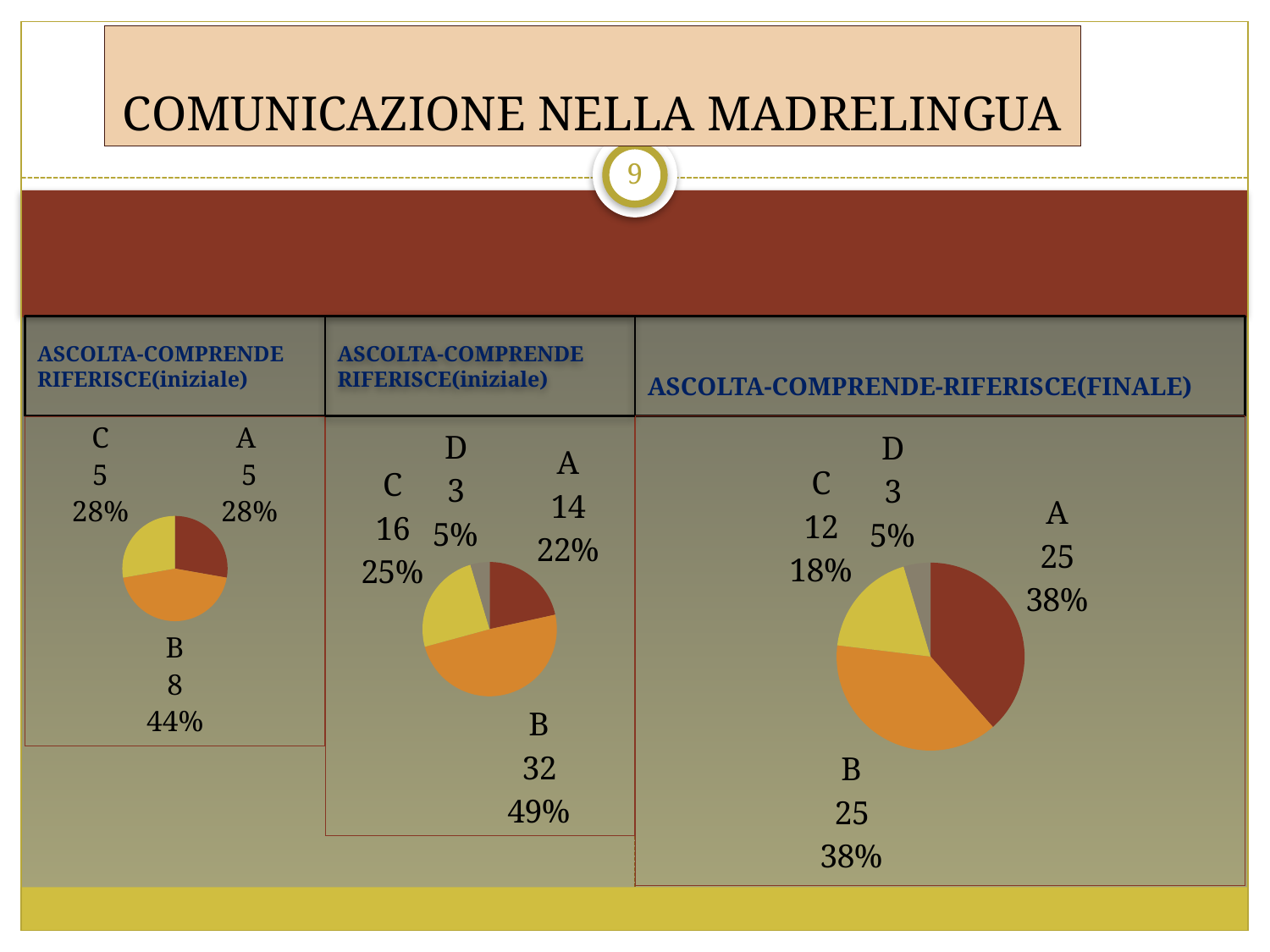
What kind of chart is used in the left-hand chart on the slide? pie chart In the left-hand pie chart, what share does category C have? 28% In the left-hand pie chart, which category has the largest slice? B In the middle pie chart, what share does category D have? 5% In the right-hand pie chart titled ASCOLTA-COMPRENDE-RIFERISCE(FINALE), what is the value for category C? 12 In the middle pie chart, what is the value for category B? 32 How many categories are shown in the left-hand pie chart? 3 In the middle pie chart, what is the difference between the values for B and C? 16 How many categories are shown in the right-hand pie chart titled ASCOLTA-COMPRENDE-RIFERISCE(FINALE)? 4 In the middle pie chart, which category has the smallest slice? D In the left-hand pie chart, what is the value for category B? 8 In the right-hand pie chart titled ASCOLTA-COMPRENDE-RIFERISCE(FINALE), which is larger, the value for A or the value for C? A